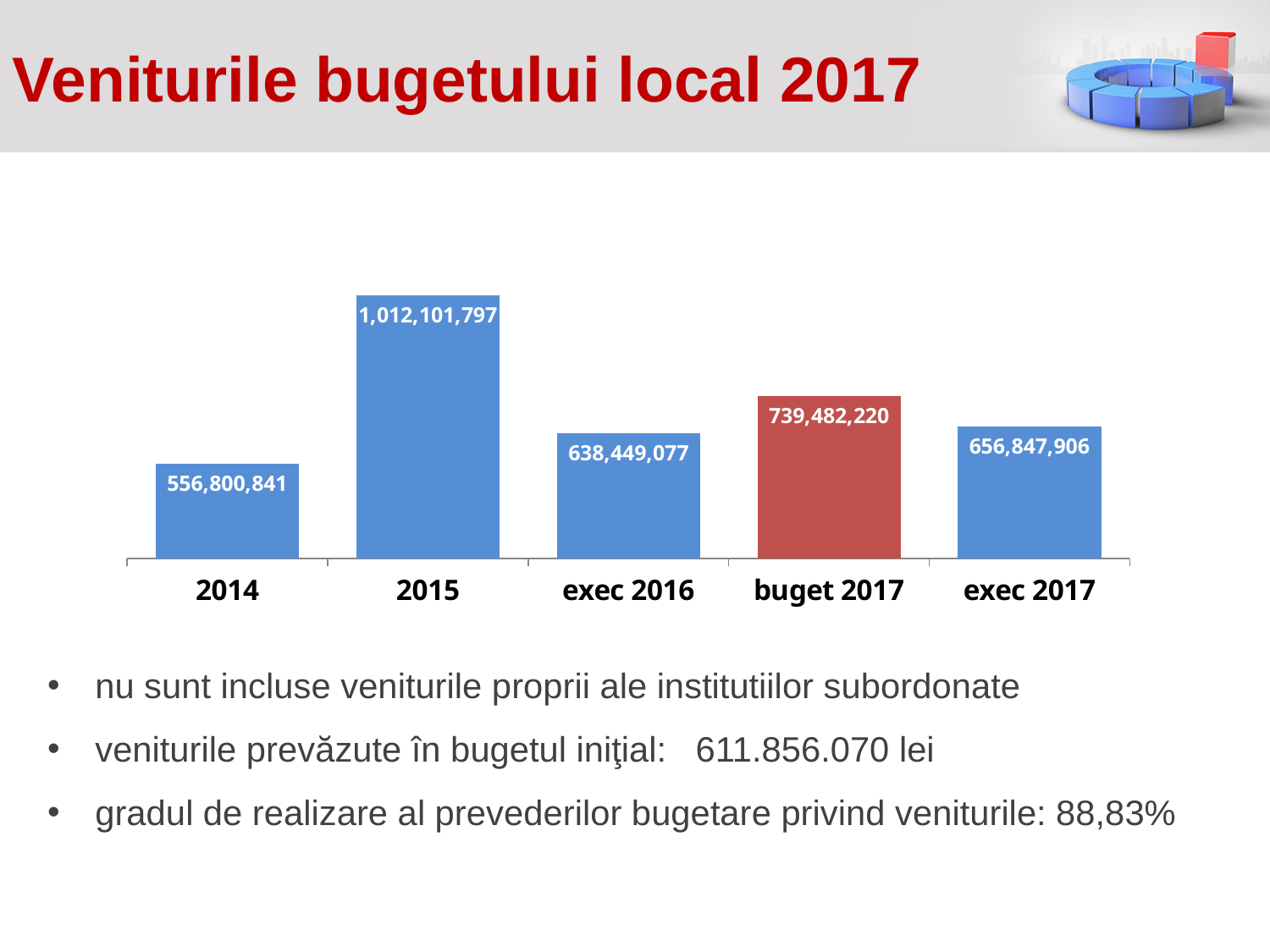
What is the value shown for 2014? 556,800,841 Does the value rise or fall from 2015 to exec 2016? fall Which category has the lowest value? 2014 What is the difference between the values for buget 2017 and exec 2017? 82,634,314 Which category's bar is coloured red instead of blue? buget 2017 How many categories are shown on the x axis? 5 Which is larger, the value for exec 2016 or the value for exec 2017? exec 2017 Which category has the highest value? 2015 What is the value shown for exec 2017? 656,847,906 What is the value shown for buget 2017? 739,482,220 What kind of chart is shown on the slide? bar chart What is the difference between the values for exec 2017 and exec 2016? 18,398,829